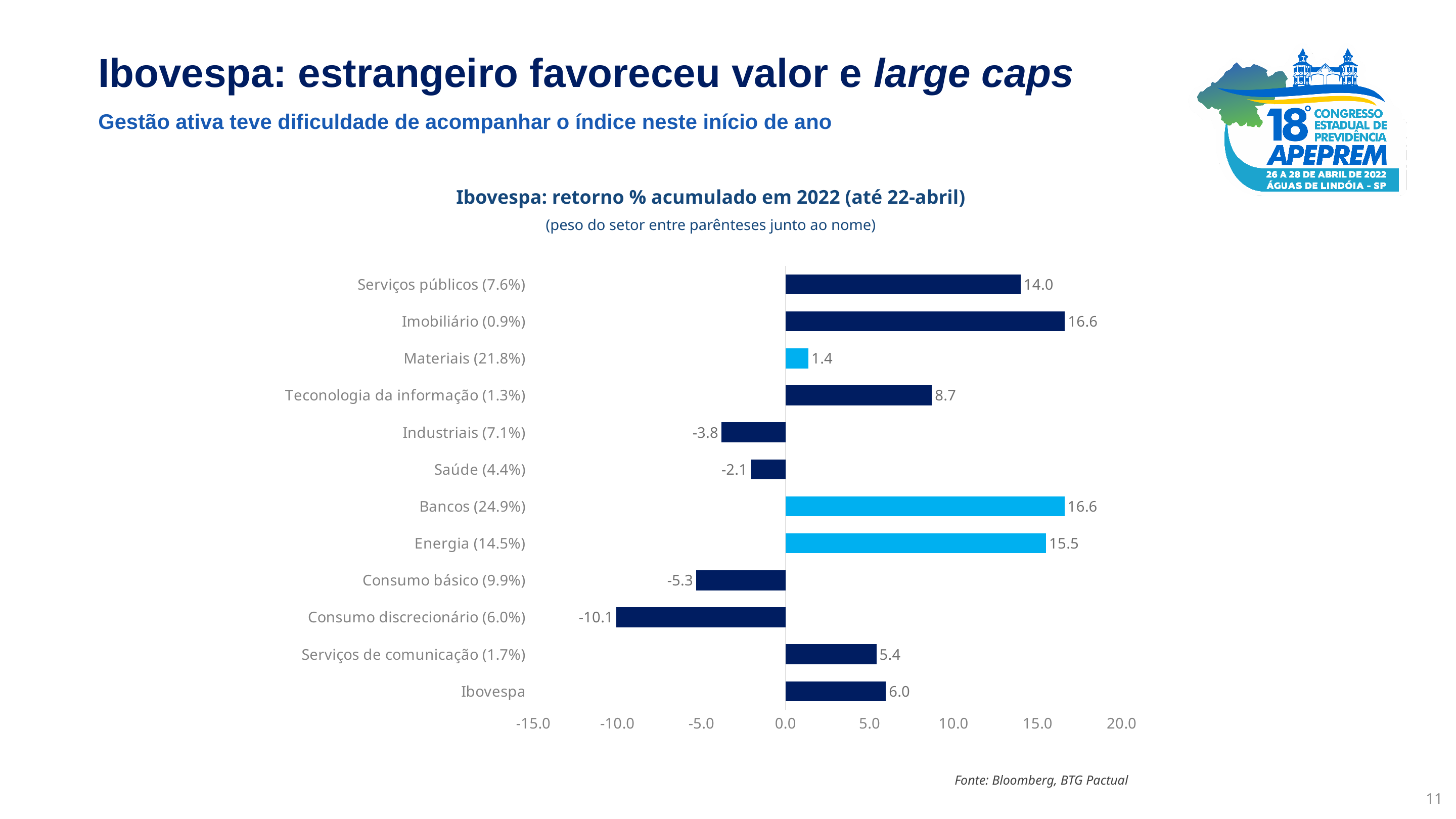
Which is larger, the value for Tecnologia da informação (1.3%) or the value for Materiais (21.8%)? Tecnologia da informação (1.3%) Is the value for Industriais (7.1%) greater or less than 0.0? less What kind of chart is shown on the slide? bar chart What is the difference between the values for Ibovespa and Serviços de comunicação (1.7%)? 0.6 What is the title of the chart? Ibovespa: retorno % acumulado em 2022 (até 22-abril) What is the value for Energia (14.5%)? 15.5 What is the value for Serviços públicos (7.6%)? 14.0 What is the difference between the values for Bancos (24.9%) and Energia (14.5%)? 1.1 What is the value for Ibovespa? 6.0 What is the value for Consumo discrecionário (6.0%)? -10.1 How many categories are shown in the chart? 12 Which category has the lowest value? Consumo discrecionário (6.0%)